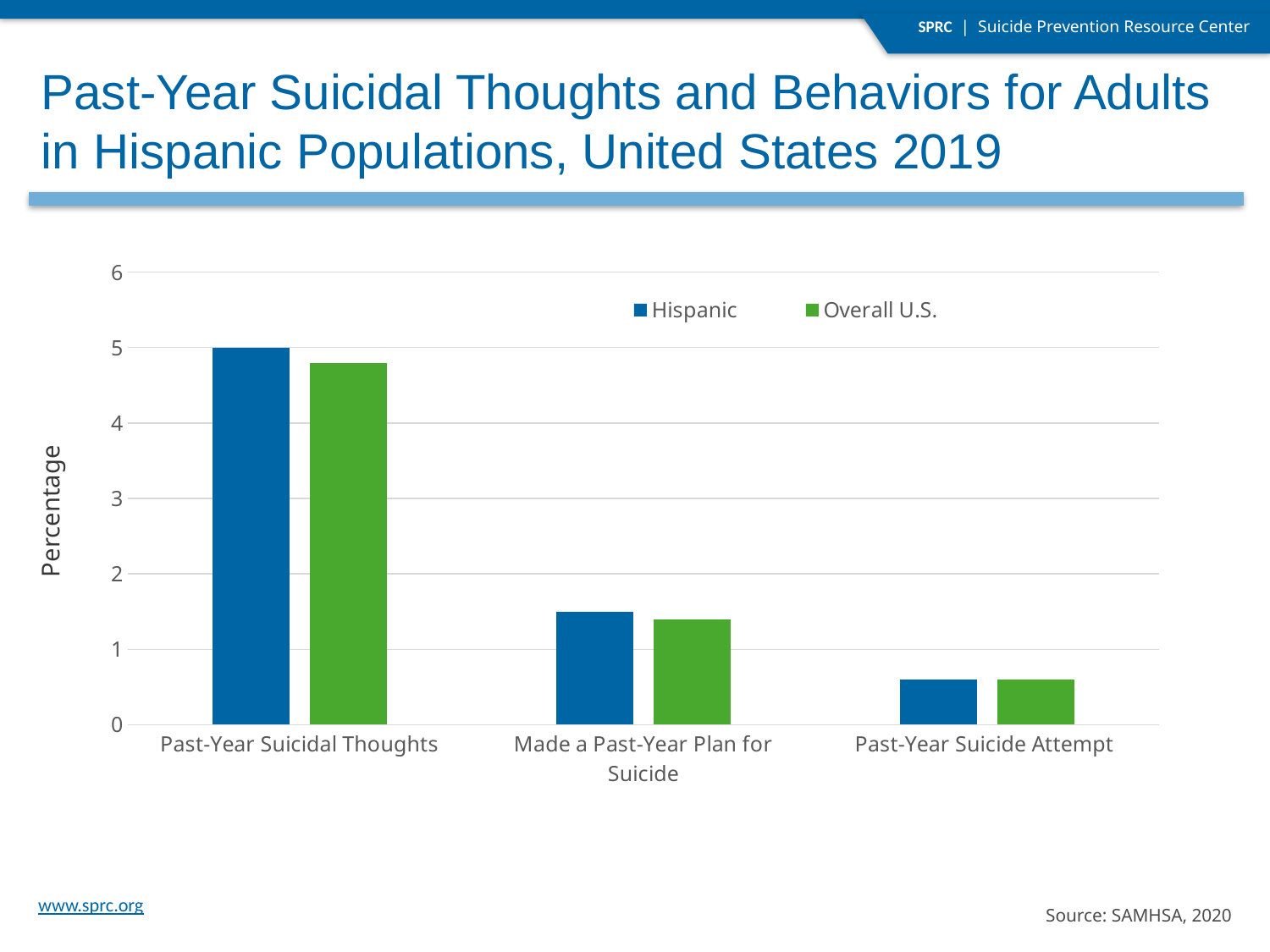
How many series does the chart legend list? 2 For Past-Year Suicidal Thoughts, which series has the larger value, Hispanic or Overall U.S.? Hispanic Is the Overall U.S. value for Past-Year Suicidal Thoughts greater or less than 4? greater Which category has the highest value for the Hispanic series? Past-Year Suicidal Thoughts Is the Hispanic value for Made a Past-Year Plan for Suicide greater or less than 2? less Is the Hispanic value for Past-Year Suicide Attempt greater or less than 1? less What is the label on the vertical axis of the chart? Percentage What are the two entries in the chart legend? Hispanic and Overall U.S. How many categories are shown on the x axis of the chart? 3 Do the Hispanic values rise or fall moving from left to right across the categories? fall What kind of chart is shown on the slide? bar chart Which category has the lowest value for the Overall U.S. series? Past-Year Suicide Attempt